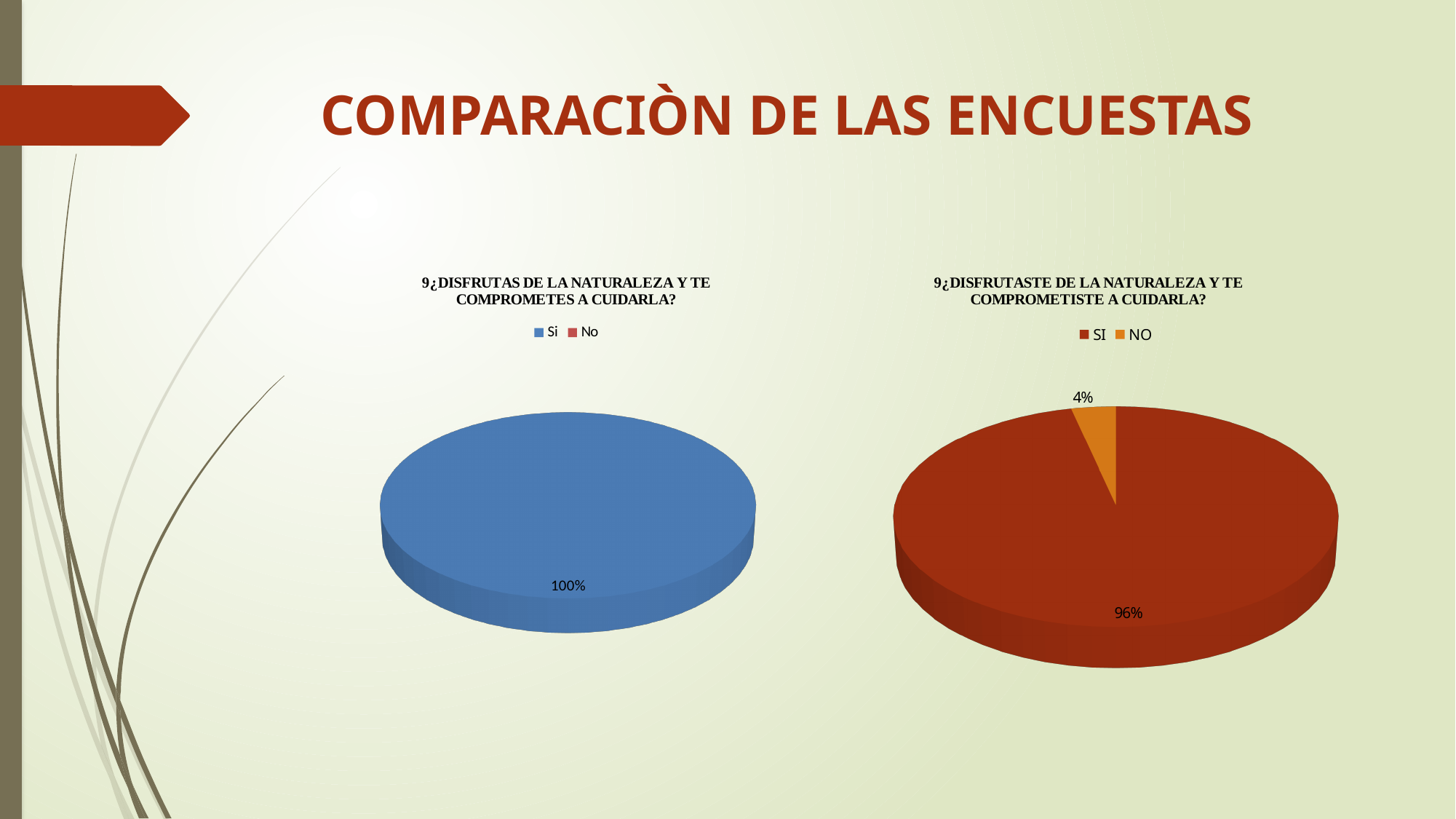
In the left chart titled "9¿DISFRUTAS DE LA NATURALEZA Y TE COMPROMETES A CUIDARLA?", what share of the pie is labelled for Si? 100% What type of chart is the left chart on the slide? Pie chart In the right chart, what is the difference in percentage points between SI and NO? 92 What is the title of the slide? COMPARACIÒN DE LAS ENCUESTAS How many entries does the legend of the left chart list? 2 In the right chart, which category has the largest slice? SI How many entries does the legend of the right chart list? 2 In the left chart, what colour is the slice for Si? Blue In the right chart titled "9¿DISFRUTASTE DE LA NATURALEZA Y TE COMPROMETISTE A CUIDARLA?", what percentage is shown for SI? 96% In the right chart, which is larger, SI or NO? SI In the right chart titled "9¿DISFRUTASTE DE LA NATURALEZA Y TE COMPROMETISTE A CUIDARLA?", what percentage is shown for NO? 4% In the right chart, which category has the smallest slice? NO